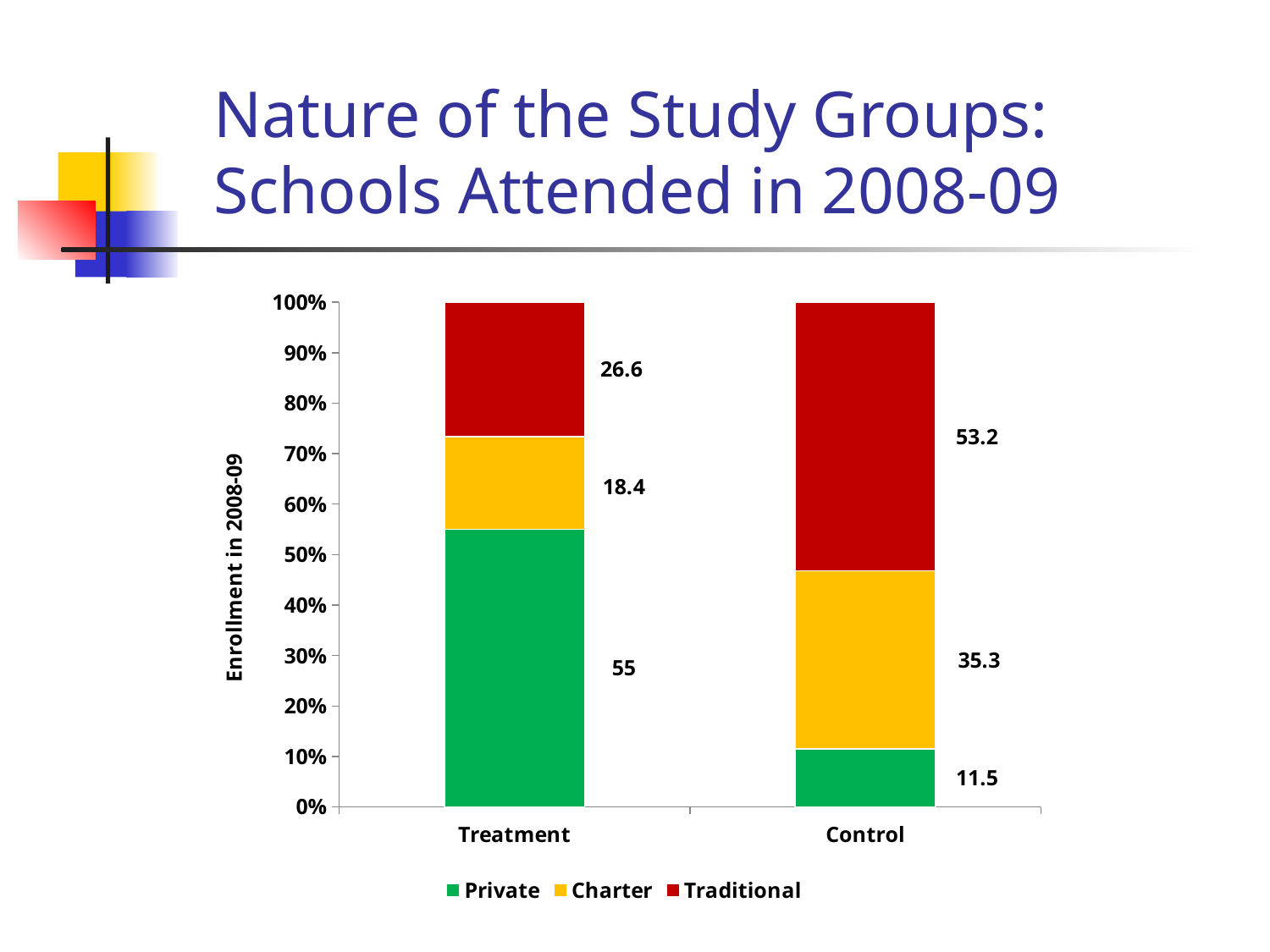
Which is larger, the Charter value for Treatment or the Charter value for Control? Control What is the label of the vertical axis? Enrollment in 2008-09 What kind of chart is shown on the slide? Stacked bar chart Which school type has the smallest share in the Control group? Private How many series does the legend list? 3 What is the Charter value for the Treatment group? 18.4 How many groups are shown on the x axis? 2 What is the Charter value for the Control group? 35.3 What is the Private value for the Treatment group? 55 What is the difference between the Traditional values for the Control and Treatment groups? 26.6 Which school type has the largest share in the Treatment group? Private What is the Traditional value for the Control group? 53.2